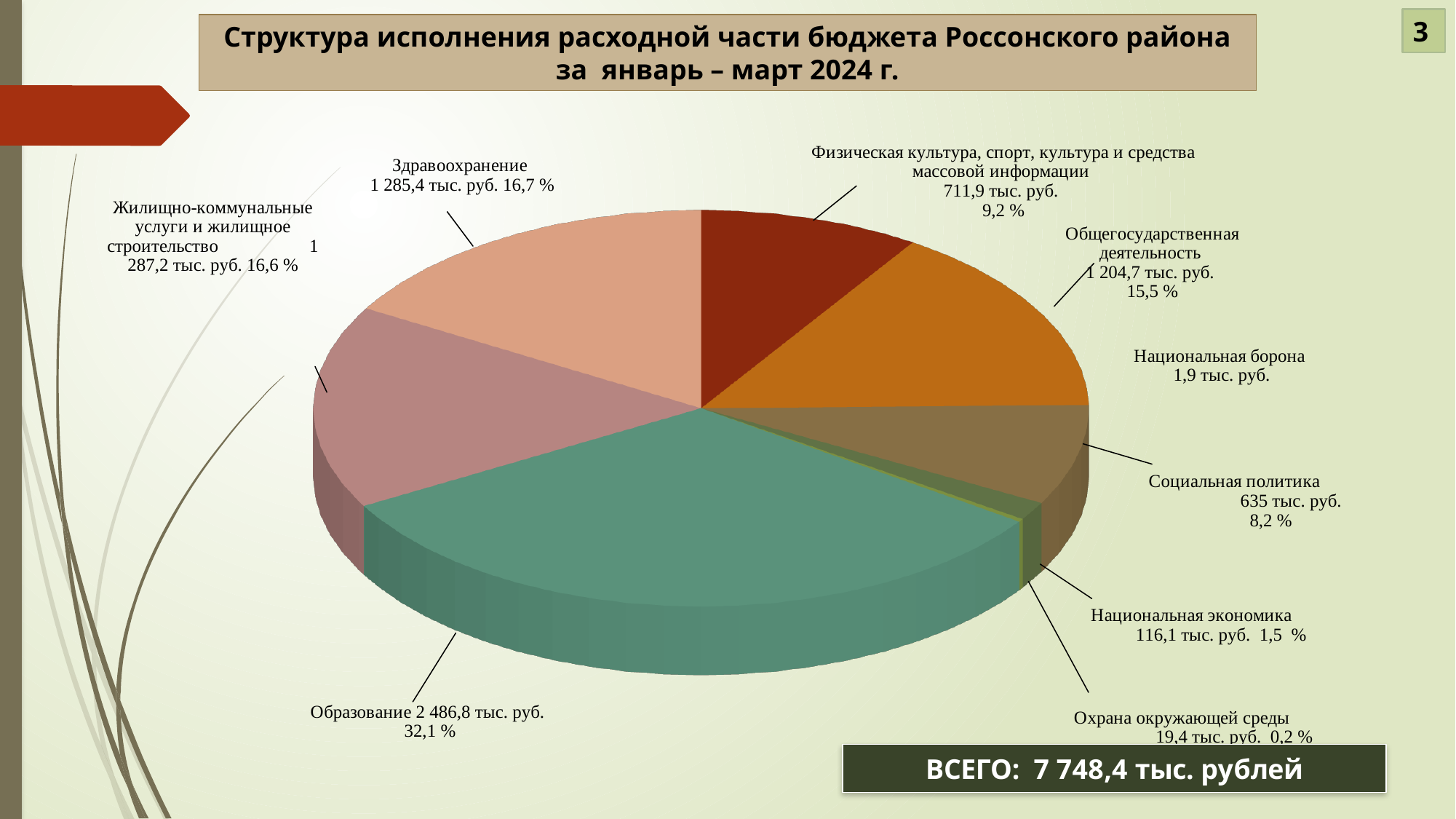
Which category has the smallest value? Национальная борона What is the total (ВСЕГО) shown on the slide? 7 748,4 тыс. рублей What is the value for Образование? 2 486,8 тыс. руб. Which is larger, the value for Здравоохранение or the value for Физическая культура, спорт, культура и средства массовой информации? Здравоохранение What period does the chart title refer to? январь – март 2024 г. What percentage is shown for Национальная экономика? 1,5 % Which category has the largest slice? Образование What is the value for Социальная политика? 635 тыс. руб. What type of chart is shown on the slide? pie chart What is the difference in value between Общегосударственная деятельность and Социальная политика? 569,7 тыс. руб. What share of the pie does Образование account for? 32,1 %